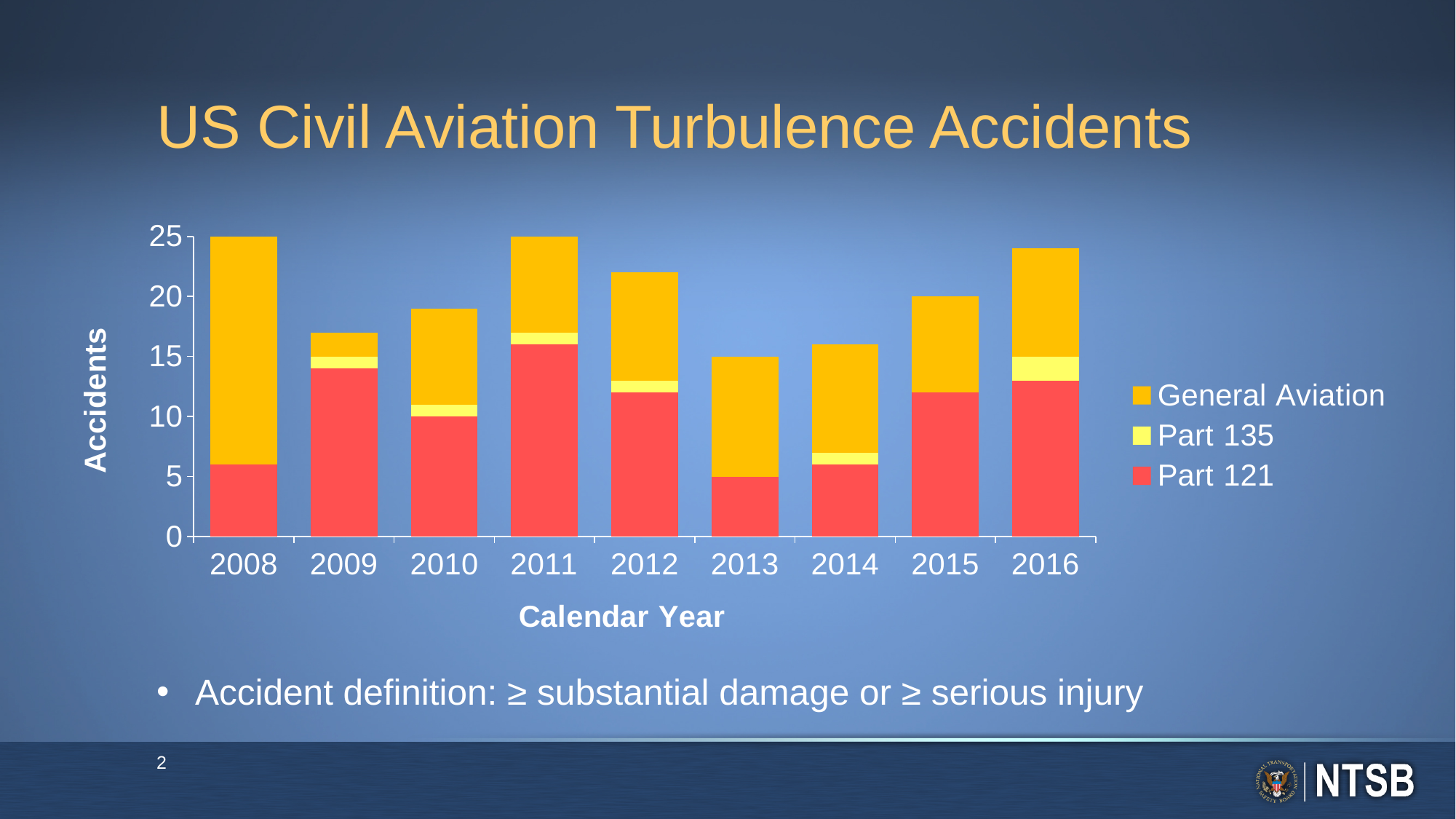
Which year has the larger Part 121 value, 2011 or 2013? 2011 What is the label on the x axis? Calendar Year How many series does the legend list? 3 What is the total number of accidents for 2015? 20 Is the total number of accidents for 2014 greater or less than 20? less How many calendar years are shown on the x axis? 9 What is the total number of accidents for 2013? 15 Is the total number of accidents for 2016 greater or less than 20? greater Which year has the larger total number of accidents, 2008 or 2009? 2008 Is the Part 121 value for 2011 greater or less than 15? greater What kind of chart is shown on the slide? bar chart What is the total number of accidents for 2008? 25